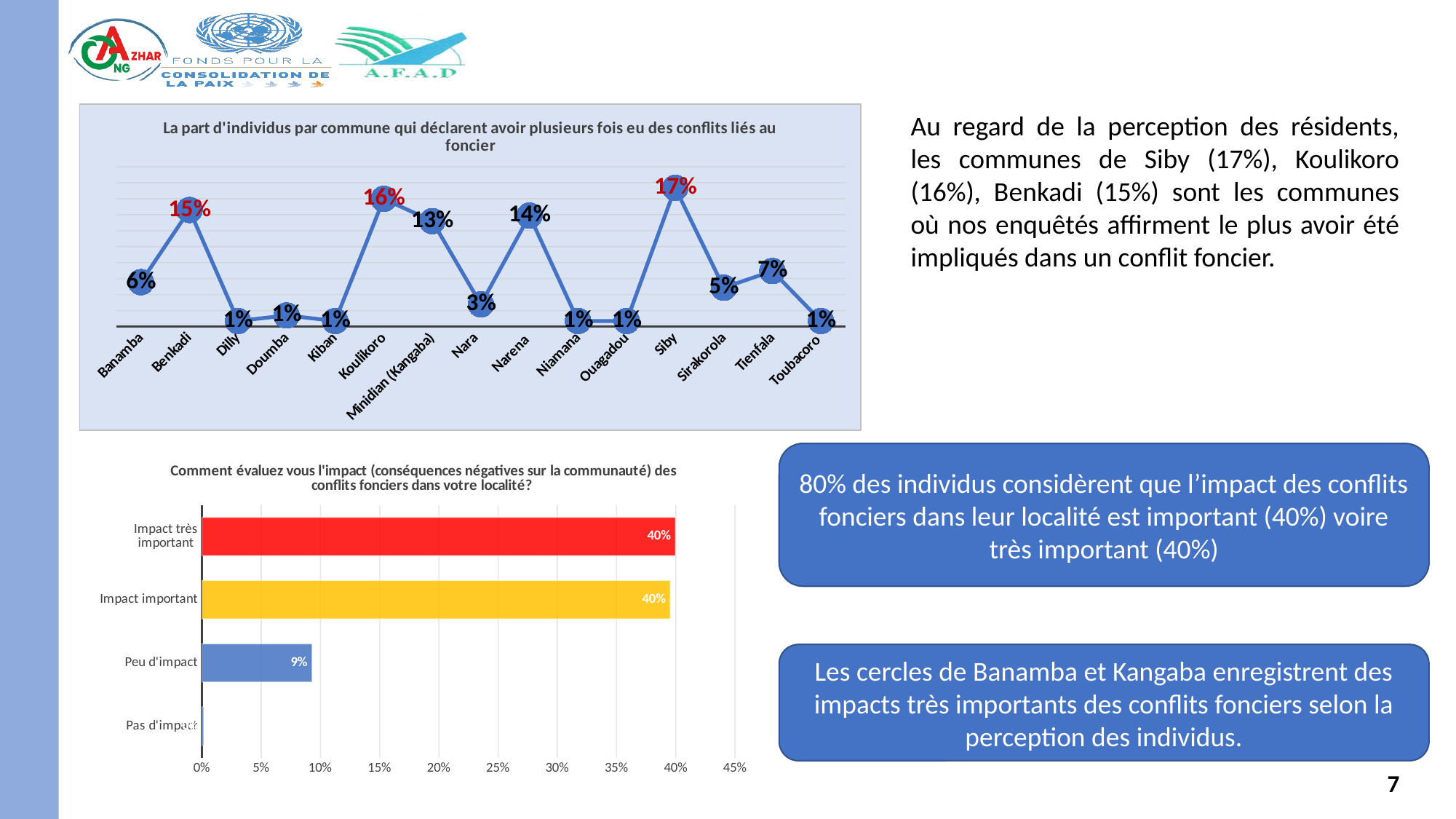
In the top chart on the share of individuals per commune reporting repeated land conflicts, what is the value for Minidian (Kangaba)? 13% In the top chart on the share of individuals per commune reporting repeated land conflicts, which is larger, Narena or Tienfala? Narena How many communes are plotted in the top chart on the share of individuals reporting repeated land conflicts? 15 What kind of chart is the top chart on the share of individuals per commune reporting repeated land conflicts? Line chart What kind of chart is the bottom chart on the evaluation of the impact of land conflicts? Bar chart How many categories are shown in the bottom chart on the evaluation of the impact of land conflicts? 4 In the top chart on the share of individuals per commune reporting repeated land conflicts, which commune has the highest value? Siby In the bottom chart on the evaluation of the impact of land conflicts, what is the value for 'Impact important'? 40% In the top chart on the share of individuals per commune reporting repeated land conflicts, what is the value for Siby? 17% In the top chart on the share of individuals per commune reporting repeated land conflicts, what is the difference between Koulikoro and Banamba? 10% In the bottom chart on the evaluation of the impact of land conflicts, which category has the lowest value? Pas d'impact In the bottom chart on the evaluation of the impact of land conflicts, what is the value for 'Peu d'impact'? 9%